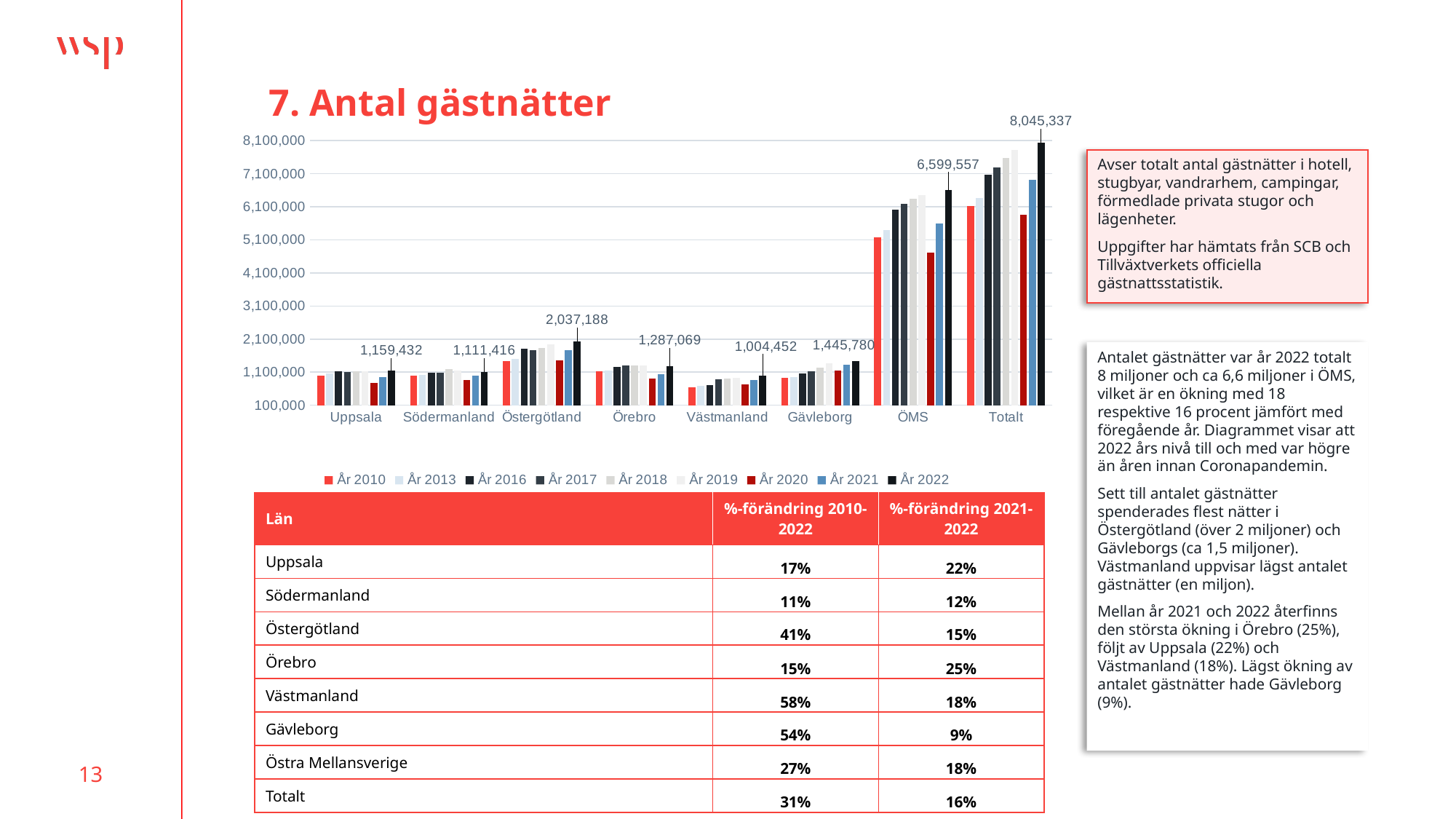
How many series does the chart legend list? 9 What is the value for ÖMS in År 2022? 6,599,557 How many categories are shown on the x axis of the chart? 8 What kind of chart is shown on the slide? Bar chart What is the difference between the År 2022 values for Gävleborg and Örebro? 158,711 Among the individual counties (excluding ÖMS and Totalt), which has the lowest År 2022 value? Västmanland Among the individual counties (excluding ÖMS and Totalt), which has the highest År 2022 value? Östergötland What is the value for Västmanland in År 2022? 1,004,452 What is the value for Totalt in År 2022? 8,045,337 Which is larger in År 2022: Uppsala or Södermanland? Uppsala What is the value for Östergötland in År 2022? 2,037,188 Is the År 2020 value for ÖMS greater or less than 5,100,000? less